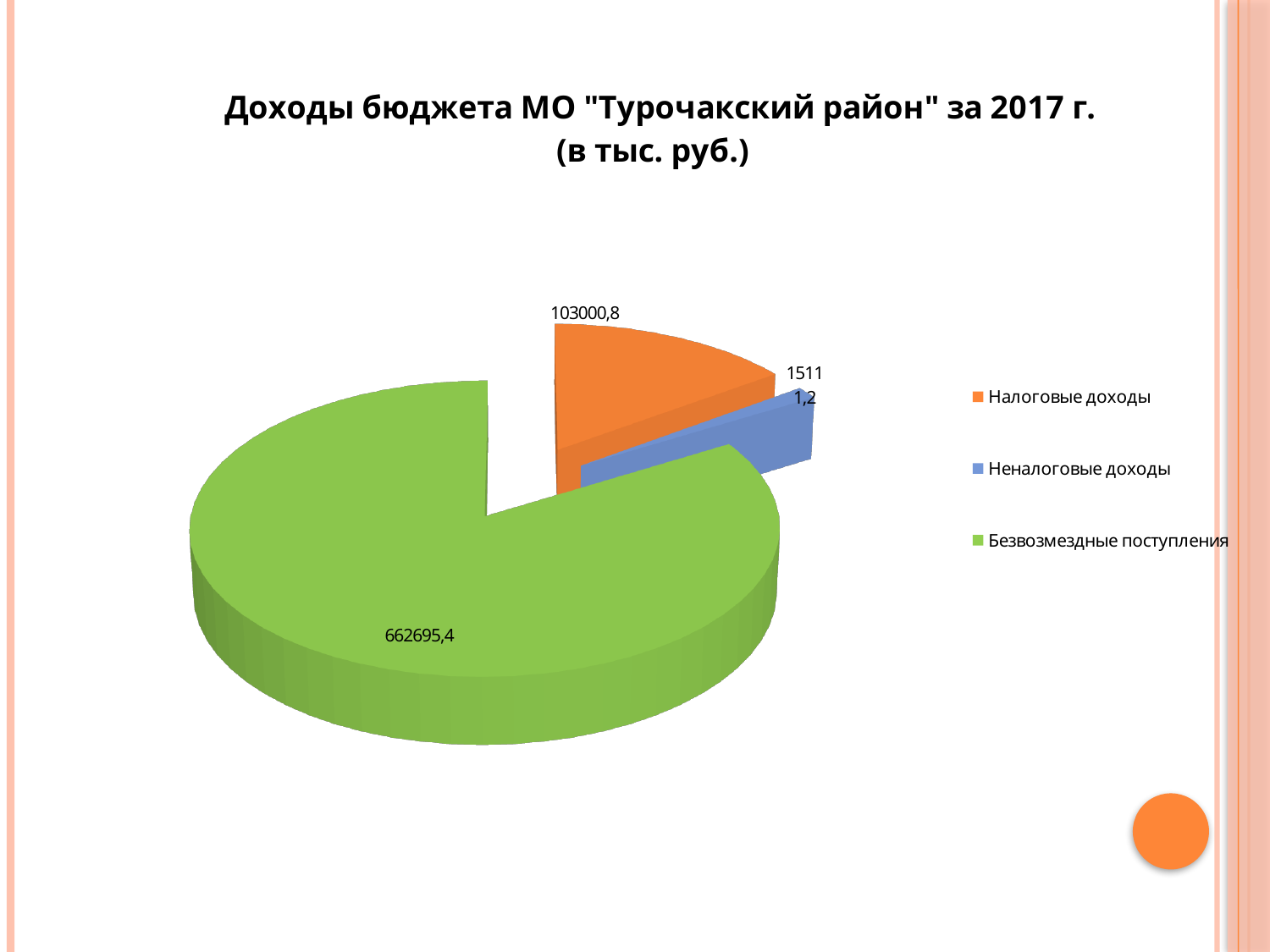
Which category has the smallest slice of the pie? Неналоговые доходы Which is larger, Налоговые доходы or Неналоговые доходы? Налоговые доходы What is the value for Безвозмездные поступления? 662695,4 What is the title of the chart? Доходы бюджета МО "Турочакский район" за 2017 г. (в тыс. руб.) Which category has the largest slice of the pie? Безвозмездные поступления What kind of chart is shown on the slide? Pie chart What is the value for Налоговые доходы? 103000,8 How many entries does the legend list? 3 What colour is the slice for Неналоговые доходы? Blue What is the difference between Безвозмездные поступления and Налоговые доходы? 559694,6 How many slices does the pie chart have? 3